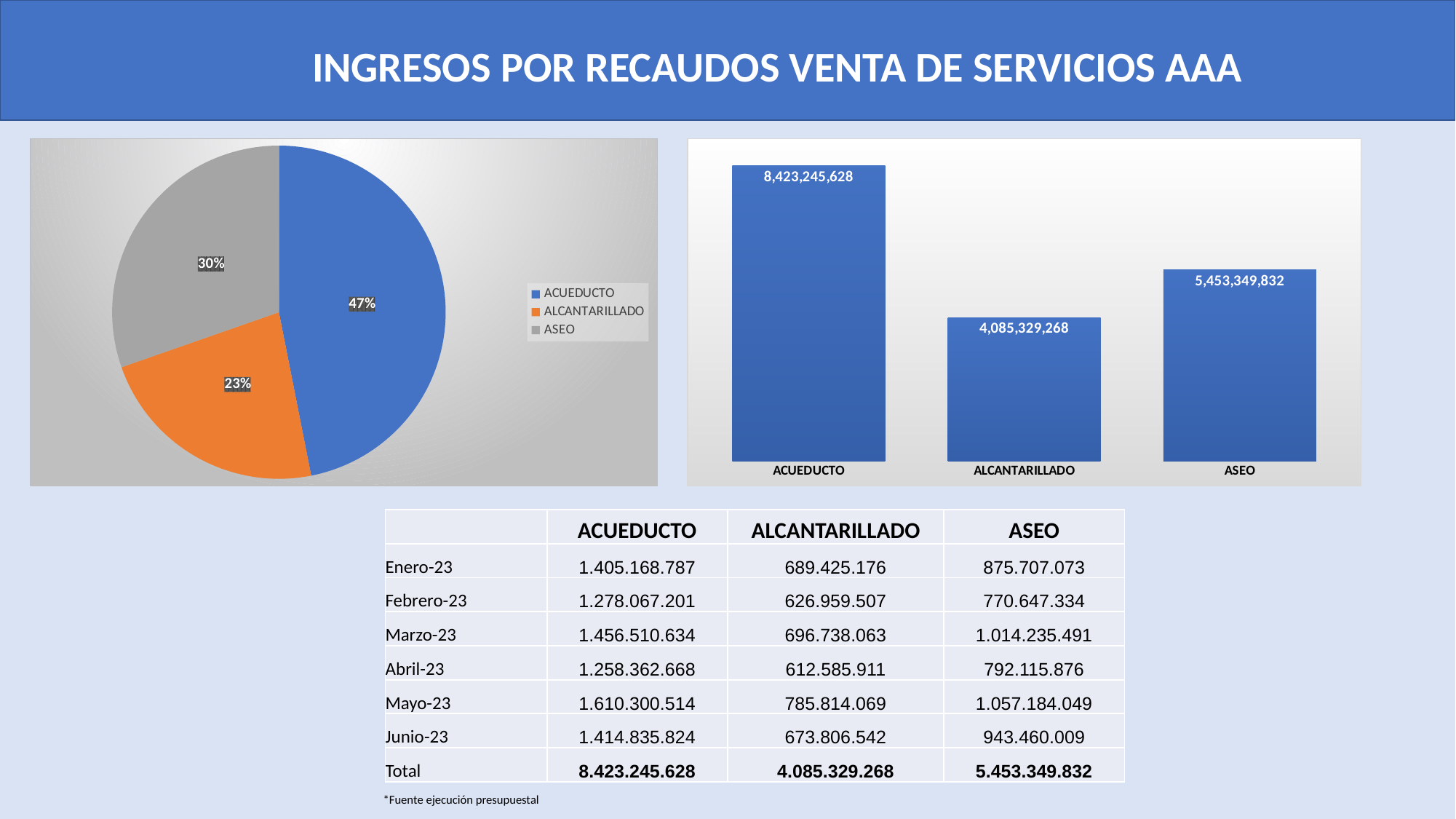
In the bar chart on the right, what is the value for ASEO? 5,453,349,832 In the bar chart on the right, what is the value for ALCANTARILLADO? 4,085,329,268 In the pie chart on the left, which slice is the smallest? ALCANTARILLADO In the bar chart on the right, what is the difference between the values for ASEO and ALCANTARILLADO? 1,368,020,564 How many categories does the bar chart on the right show? 3 In the pie chart on the left, what share does ACUEDUCTO have? 47% In the bar chart on the right, which category has the highest value? ACUEDUCTO In the bar chart on the right, which is larger, the value for ASEO or the value for ALCANTARILLADO? ASEO In the bar chart on the right, which category has the lowest value? ALCANTARILLADO In the bar chart on the right, what is the value for ACUEDUCTO? 8,423,245,628 In the bar chart on the right, what is the difference between the values for ACUEDUCTO and ALCANTARILLADO? 4,337,916,360 In the pie chart on the left, what share does ASEO have? 30%